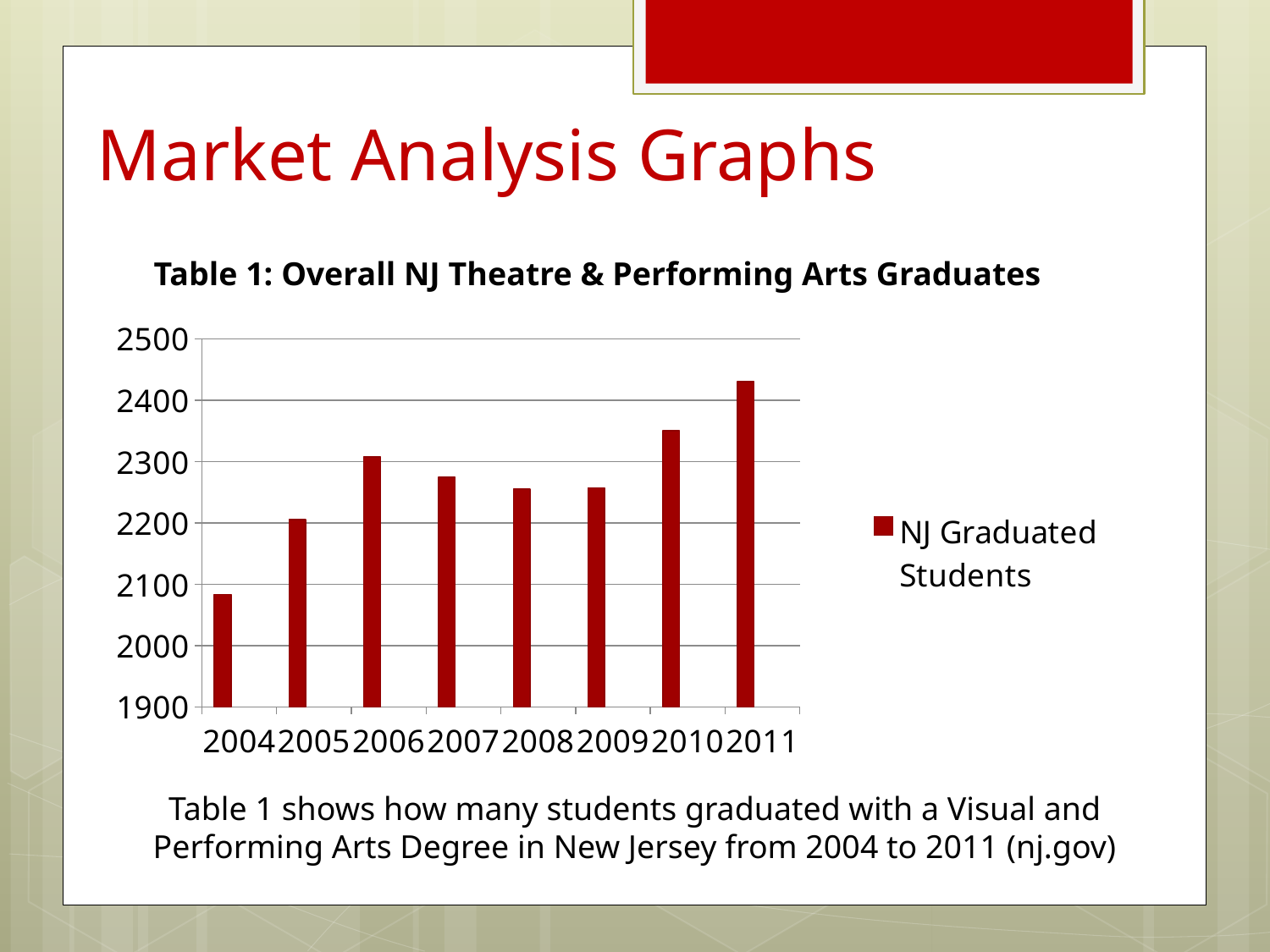
Overall, do the values rise or fall from 2004 to 2011? rise How many series does the legend list? 1 Is the value for 2011 greater or less than 2400? greater Which year has the highest number of NJ graduated students? 2011 Which year has the lowest number of NJ graduated students? 2004 Which year has more NJ graduated students, 2005 or 2008? 2008 What kind of chart is shown on the slide? bar chart How many years are shown on the x axis of the chart? 8 Is the value for 2004 greater or less than 2100? less What is the title of the chart? Table 1: Overall NJ Theatre & Performing Arts Graduates Is the value for 2010 greater or less than 2400? less